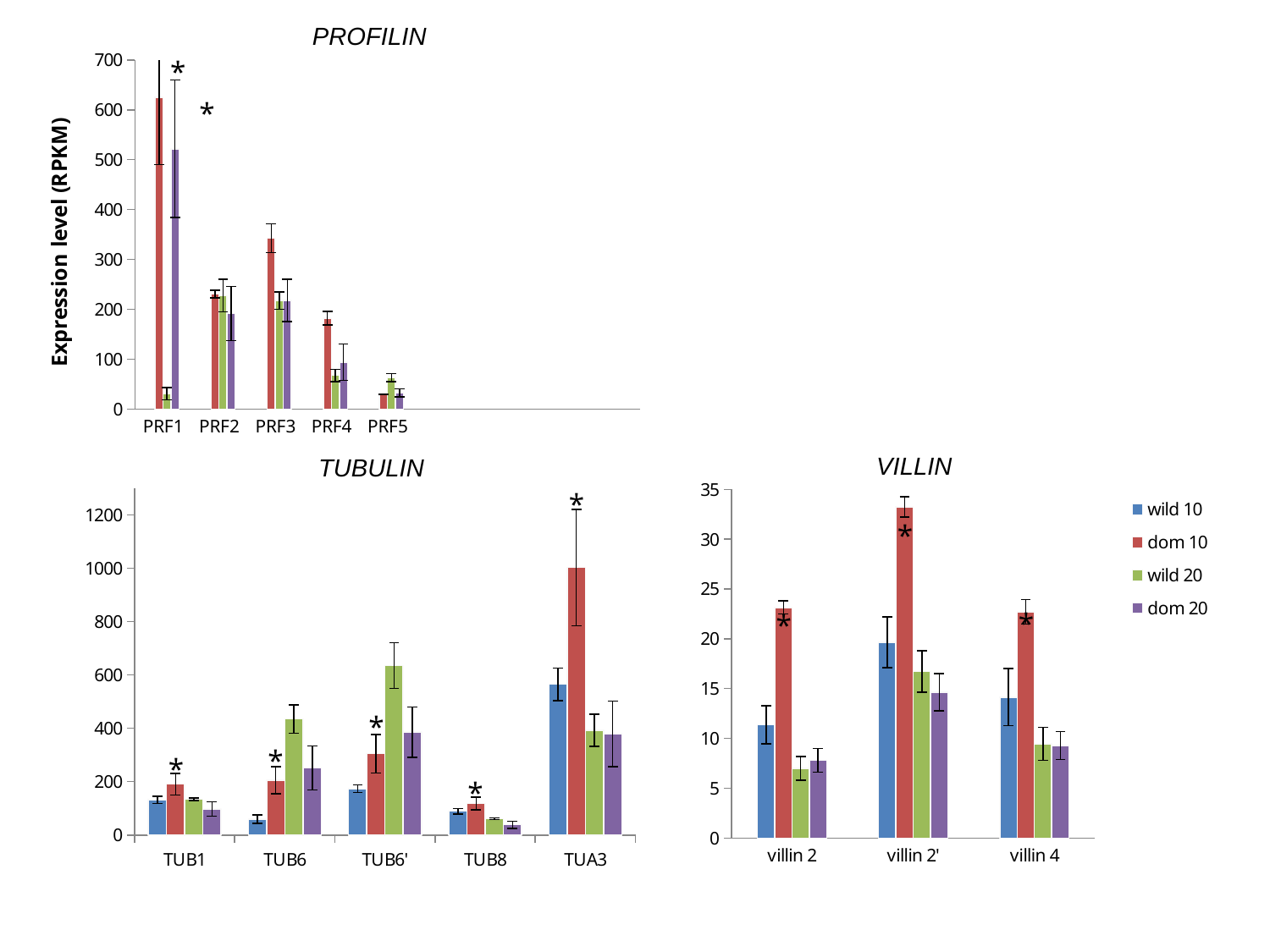
In the TUBULIN chart, is the value for wild 20 at TUB6' greater or less than 400? greater How many categories are shown on the x axis of the VILLIN chart? 3 How many categories are shown on the x axis of the PROFILIN chart? 5 What is the y-axis label of the PROFILIN chart? Expression level (RPKM) In the TUBULIN chart, which category has the highest dom 10 bar? TUA3 In the PROFILIN chart, is the value for dom 10 at PRF1 greater or less than 500? greater What kind of chart is the PROFILIN chart? bar chart How many series does the legend list? 4 In the PROFILIN chart, which category has the highest dom 10 bar? PRF1 In the TUBULIN chart, is the value for dom 10 at TUA3 greater or less than 800? greater